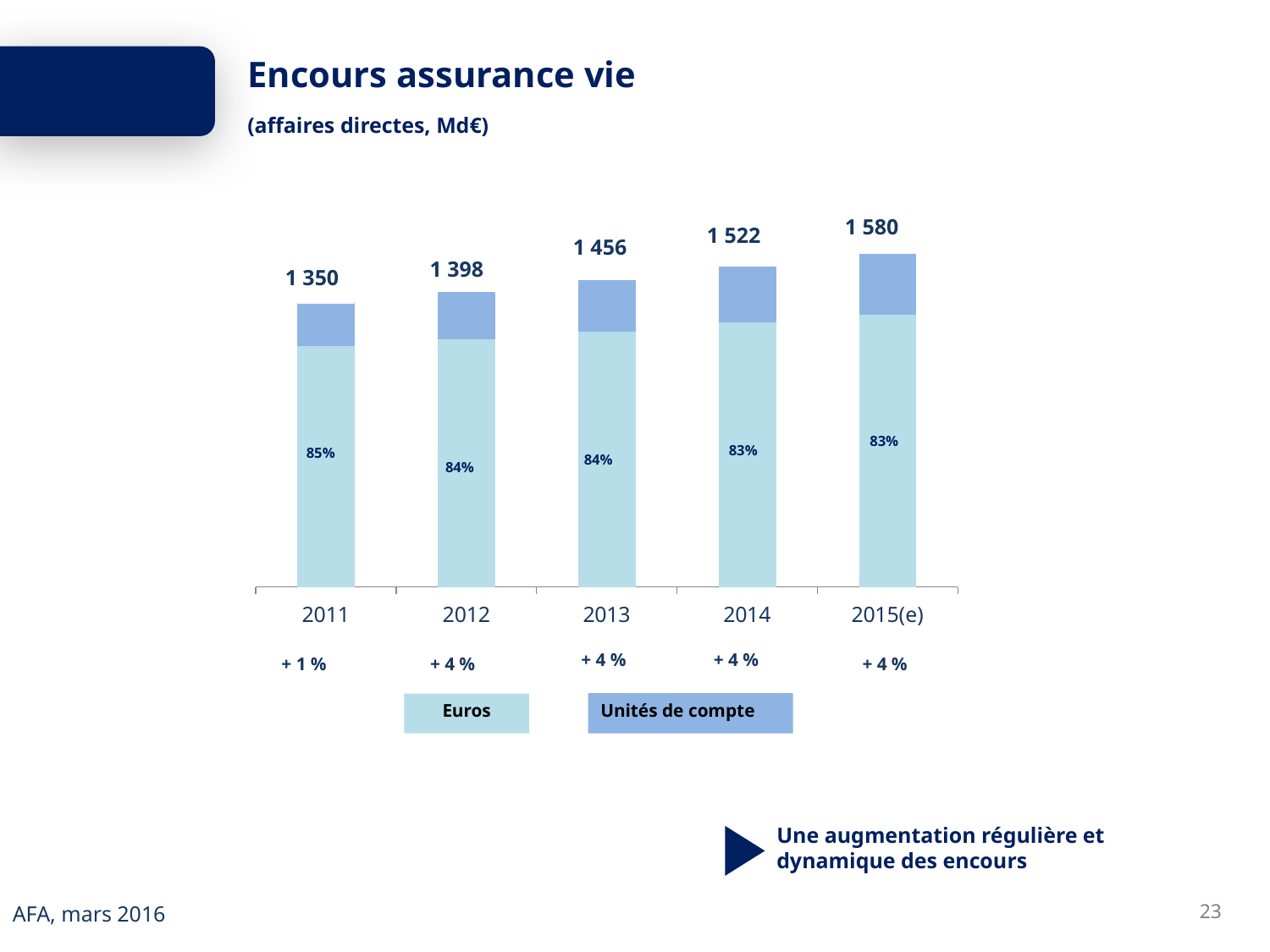
What percentage of the 2011 bar is labelled as Euros? 85% What is the total value shown for 2011? 1 350 Which is larger, the total for 2013 or the total for 2014? 2014 What percentage of the 2013 bar is labelled as Euros? 84% What is the difference between the total for 2015(e) and the total for 2011? 230 Which year has the lowest total value? 2011 How many series does the legend list? 2 How many years are shown on the x axis? 5 What kind of chart is shown on the slide? Stacked bar chart What is the total value shown for 2015(e)? 1 580 Which year has the highest total value? 2015(e) Do the total values rise or fall from 2011 to 2015(e)? Rise